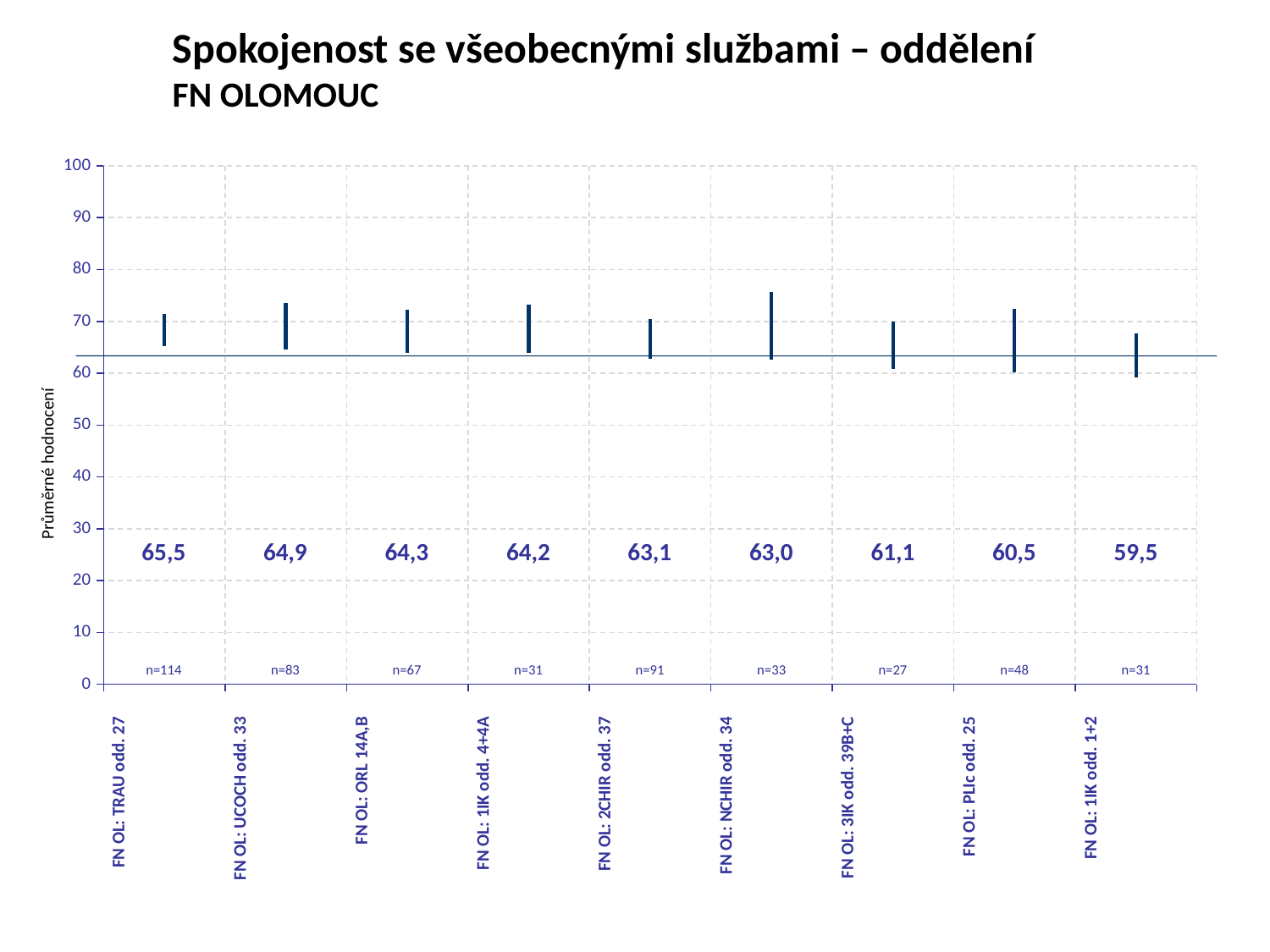
Which department has the largest sample size (n)? FN OL: TRAU odd. 27 What is the label of the vertical axis? Průměrné hodnocení What is the difference between the average ratings of FN OL: TRAU odd. 27 and FN OL: 1IK odd. 1+2? 6,0 What is the average rating for FN OL: NCHIR odd. 34? 63,0 What is the sample size (n) shown for FN OL: 2CHIR odd. 37? n=91 How many departments are shown on the chart? 9 Which department has the highest average rating? FN OL: TRAU odd. 27 Which department has the lowest average rating? FN OL: 1IK odd. 1+2 What is the average rating for FN OL: TRAU odd. 27? 65,5 Which has a higher average rating, FN OL: UCOCH odd. 33 or FN OL: 3IK odd. 39B+C? FN OL: UCOCH odd. 33 Do the average ratings rise or fall from left to right along the x axis? fall What is the average rating for FN OL: PLIc odd. 25? 60,5